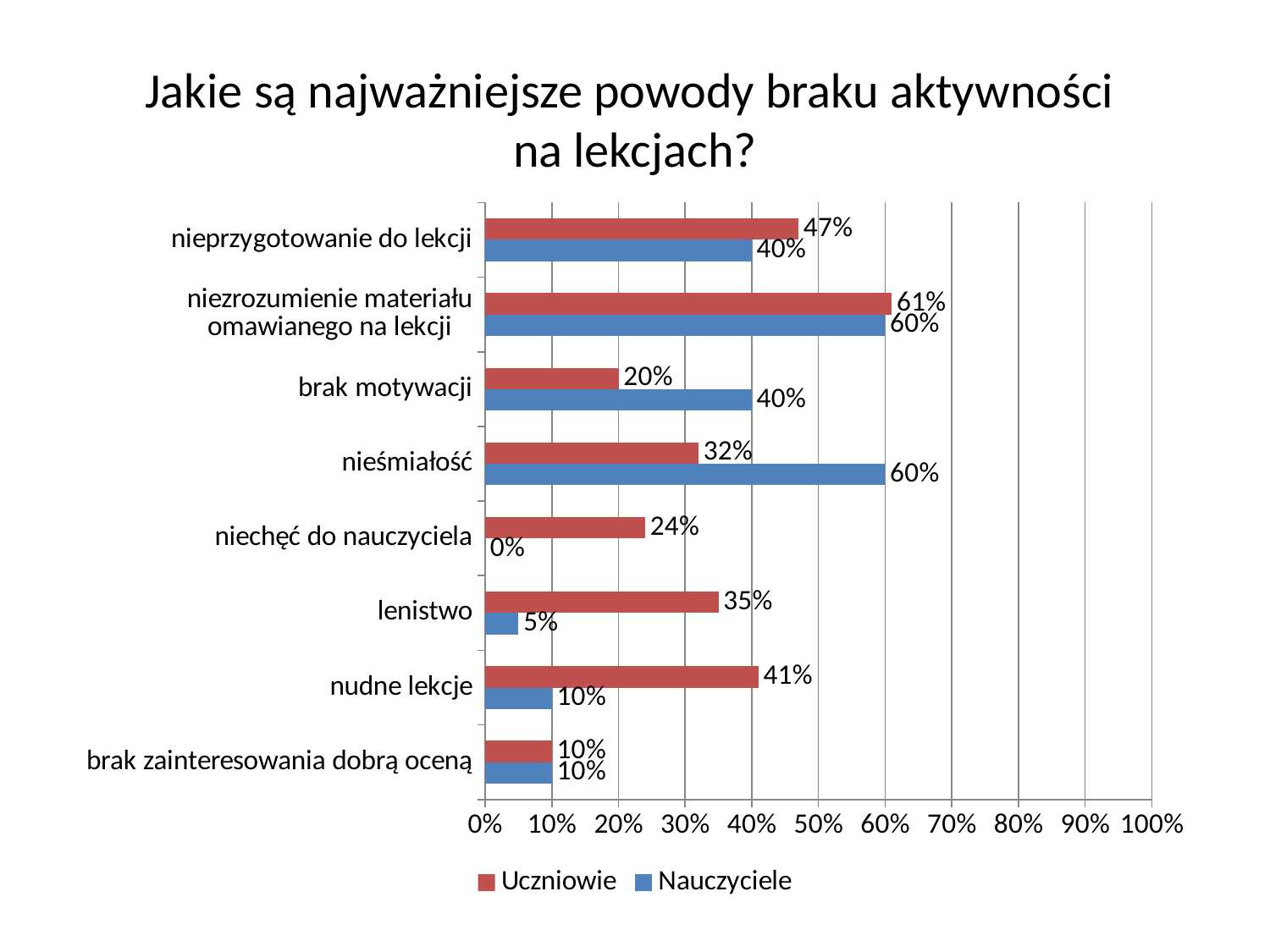
Is the Uczniowie value for nudne lekcje greater or less than 30%? greater What is the difference between the Nauczyciele and Uczniowie values for brak motywacji? 20% What kind of chart is shown on the slide? bar chart What is the Uczniowie value for nieprzygotowanie do lekcji? 47% What is the Nauczyciele value for nieśmiałość? 60% How many categories are shown on the chart? 8 How many series does the legend list? 2 Which category has the highest Uczniowie value? niezrozumienie materiału omawianego na lekcji Which colour represents the Nauczyciele series? blue For lenistwo, which series has the larger value, Uczniowie or Nauczyciele? Uczniowie What is the Nauczyciele value for niechęć do nauczyciela? 0% Which category has the lowest Nauczyciele value? niechęć do nauczyciela